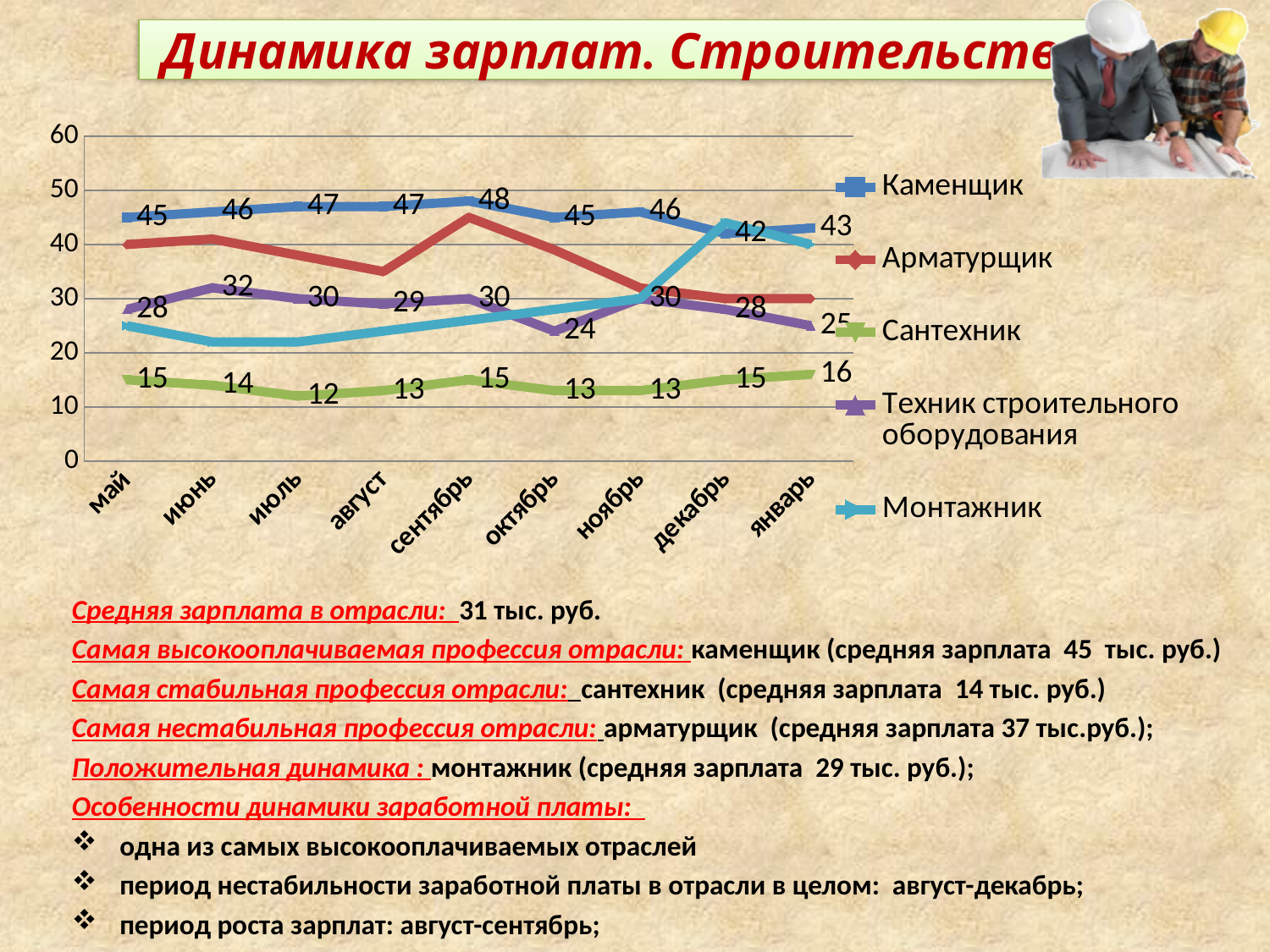
How many months are shown on the x axis? 9 Is the value for Арматурщик in сентябрь greater or less than 40? greater What is the value for Каменщик in сентябрь? 48 Which is larger for Техник строительного оборудования: the value in июнь or in октябрь? июнь What is the value for Сантехник in июль? 12 In which month is the value for Каменщик highest? сентябрь In which month is the value for Сантехник lowest? июль Do the values for Сантехник rise or fall from ноябрь to январь? rise What kind of chart is shown on the slide? line chart What is the difference between the Каменщик values in май and январь? 2 Is the value for Монтажник in июнь greater or less than 30? less How many series does the legend list? 5